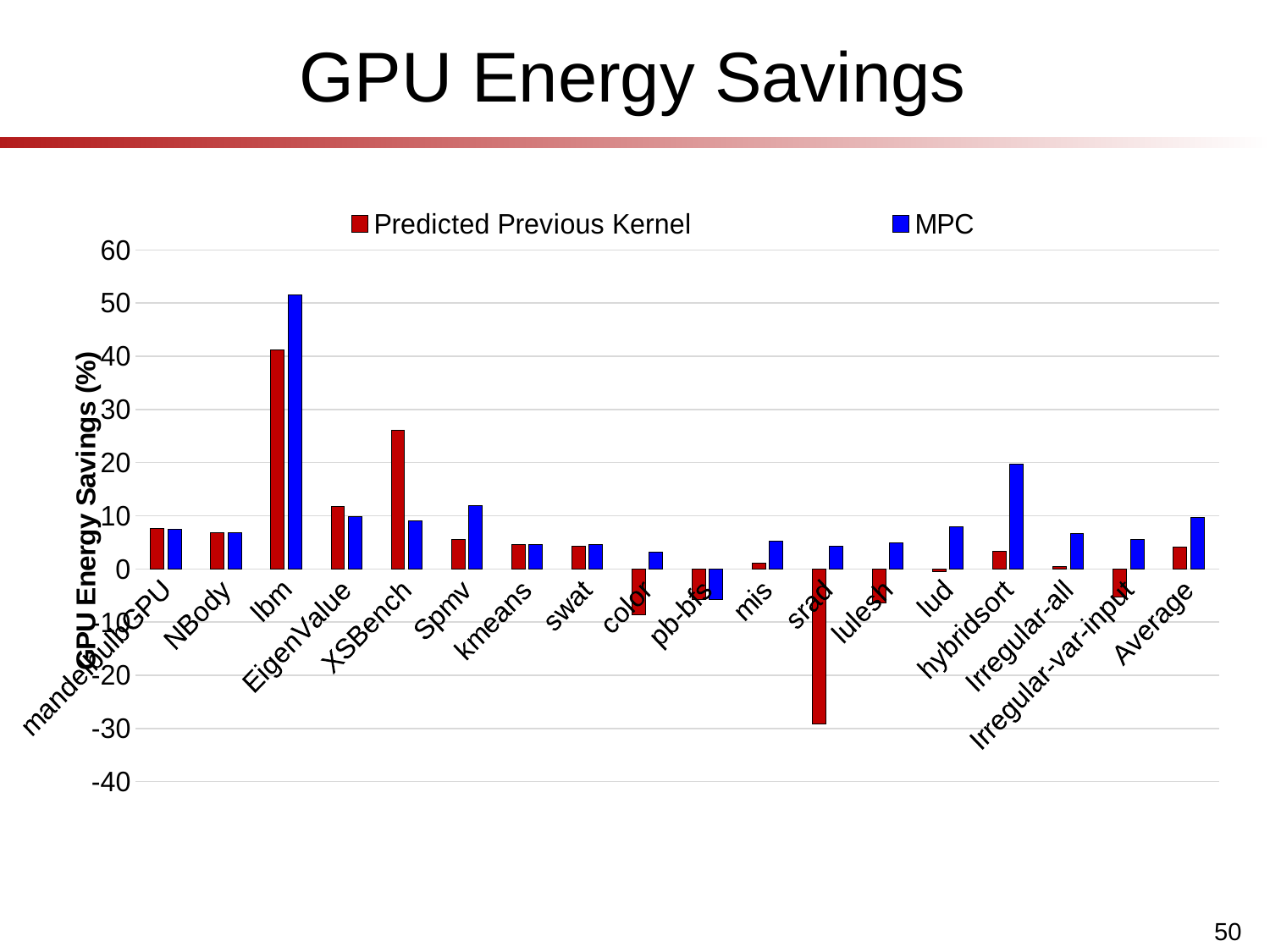
For hybridsort, which series has the larger value, Predicted Previous Kernel or MPC? MPC Which category has the highest MPC value? lbm What kind of chart is shown on the slide? bar chart For XSBench, which series has the larger value, Predicted Previous Kernel or MPC? Predicted Previous Kernel Which category has the highest Predicted Previous Kernel value? lbm What is the label of the y axis? GPU Energy Savings (%) Which category has the lowest Predicted Previous Kernel value? srad How many categories are plotted along the x axis? 18 How many series does the legend list? 2 Is the Predicted Previous Kernel value for srad greater or less than -20? less Is the MPC value for lbm greater or less than 40? greater Is the Predicted Previous Kernel value for XSBench greater or less than 20? greater